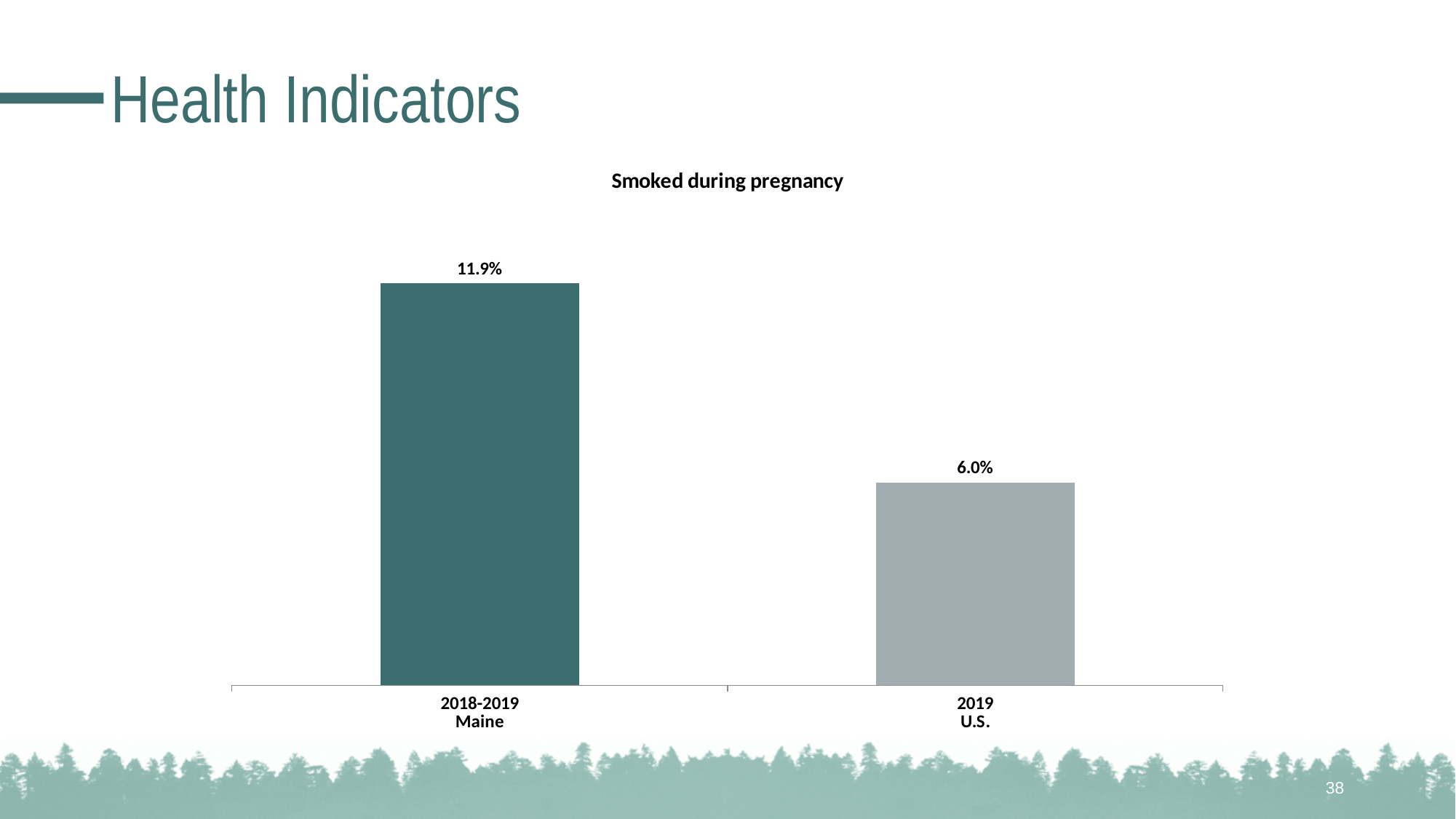
What is the difference between the Maine value and the U.S. value in the Smoked during pregnancy chart? 5.9% What is the value for 2019 U.S. in the Smoked during pregnancy chart? 6.0% How many bars are shown in the Smoked during pregnancy chart? 2 Which category has the lowest value in the Smoked during pregnancy chart? 2019 U.S. Which category has the highest value in the Smoked during pregnancy chart? 2018-2019 Maine What is the title of the chart on the slide? Smoked during pregnancy What is the value for 2018-2019 Maine in the Smoked during pregnancy chart? 11.9% What kind of chart is shown on the slide? Bar chart What colour is the bar for 2018-2019 Maine in the Smoked during pregnancy chart? Dark teal Which is larger in the Smoked during pregnancy chart: the value for 2018-2019 Maine or the value for 2019 U.S.? 2018-2019 Maine